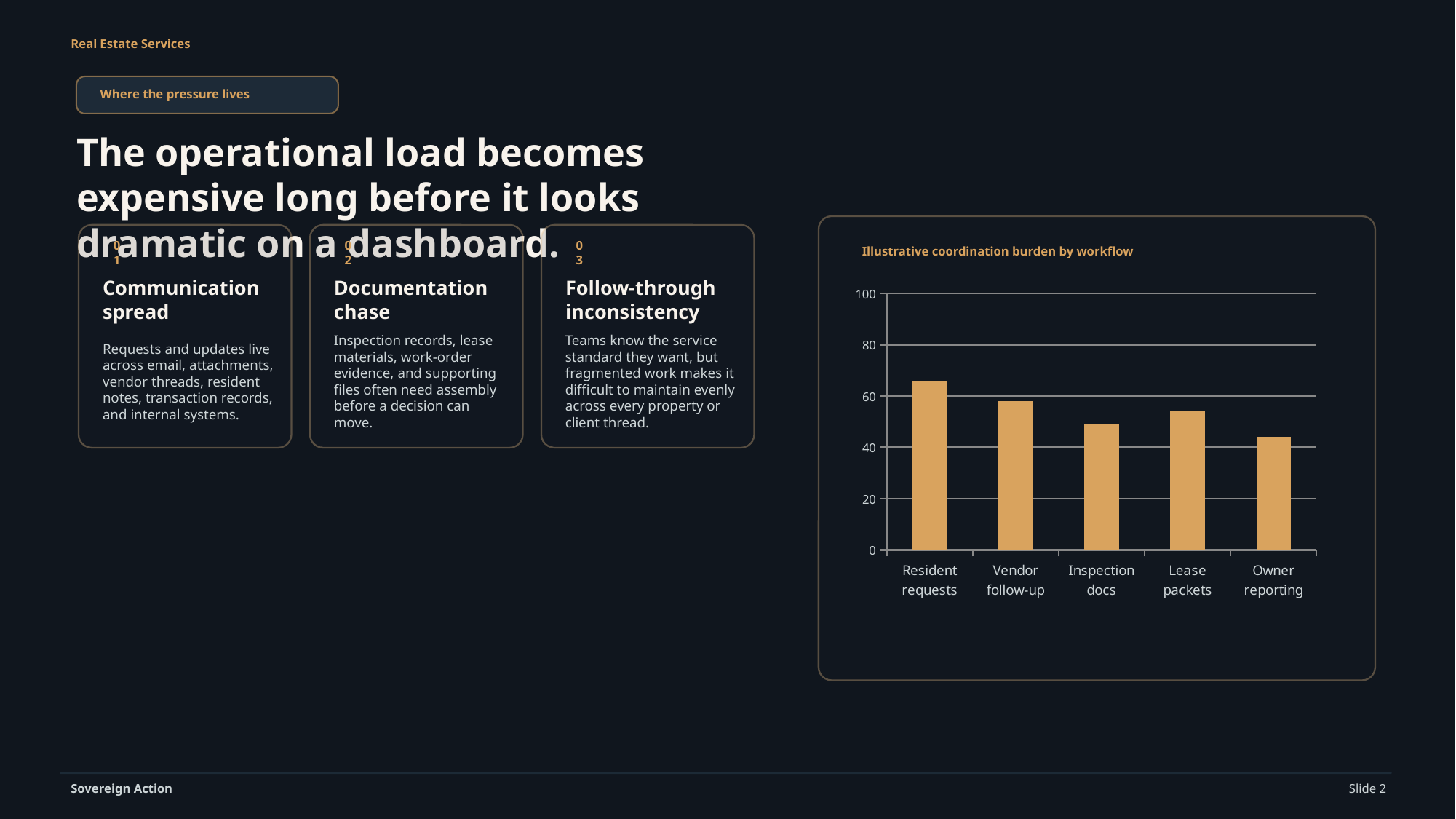
Which workflow has the highest coordination burden? Resident requests Which is larger, the value for Vendor follow-up or the value for Inspection docs? Vendor follow-up What kind of chart is shown on the slide? Bar chart Which workflow has the lowest coordination burden? Owner reporting Is the value for Lease packets greater or less than 60? less Is the value for Owner reporting greater or less than 60? less Which is larger, the value for Lease packets or the value for Owner reporting? Lease packets Is the value for Resident requests greater or less than 60? greater How many workflow categories are plotted on the chart? 5 What is the title of the chart? Illustrative coordination burden by workflow